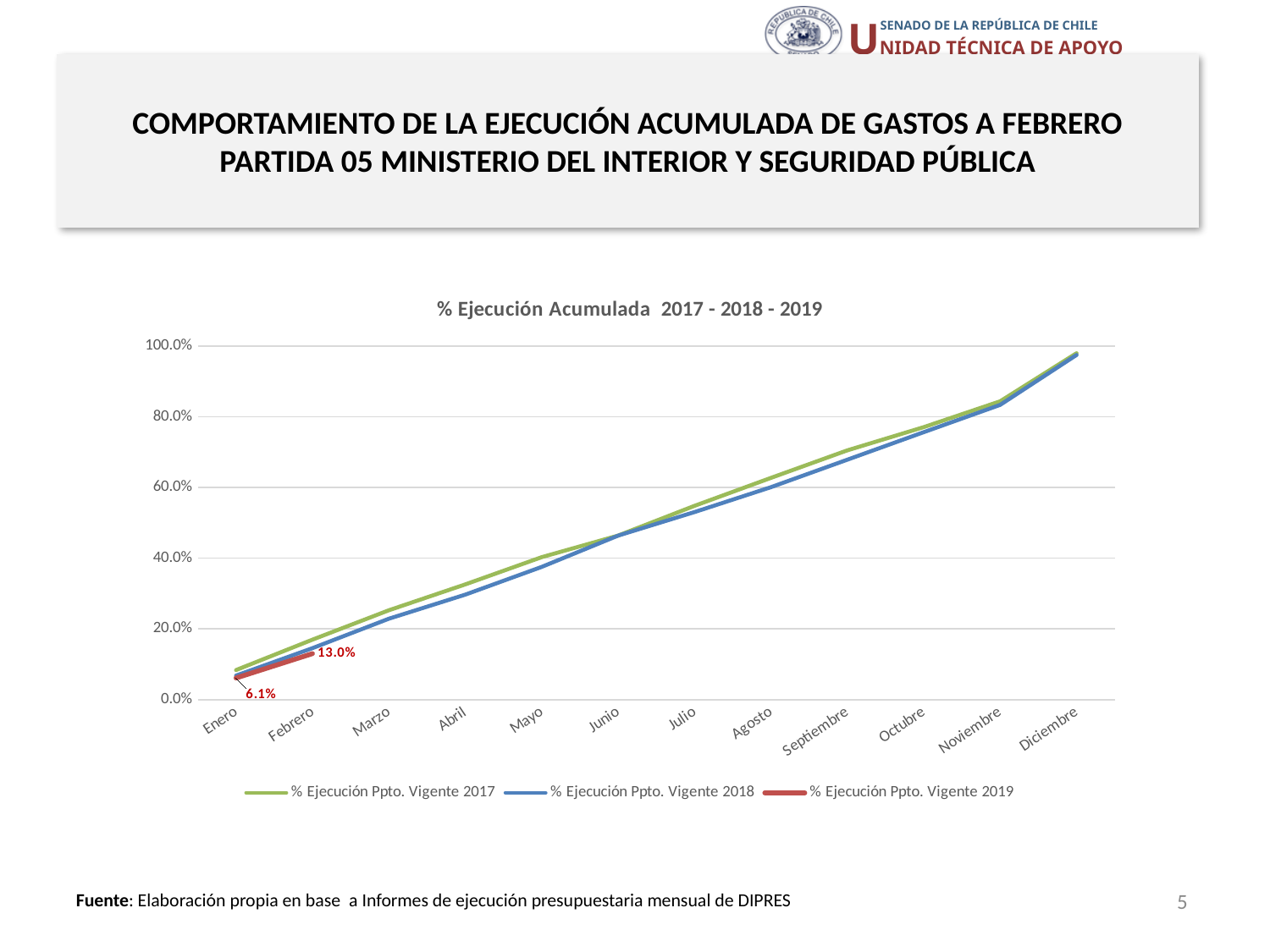
By how much did % Ejecución Ppto. Vigente 2019 increase from Enero to Febrero? 6.9% What is the value for % Ejecución Ppto. Vigente 2019 in Febrero? 13.0% How many series does the legend list? 3 How many months are shown on the x axis? 12 Is the value for % Ejecución Ppto. Vigente 2018 in Marzo greater or less than 40.0%? less What is the value for % Ejecución Ppto. Vigente 2019 in Enero? 6.1% Do the values for % Ejecución Ppto. Vigente 2017 rise or fall from Enero to Diciembre? Rise Is the value for % Ejecución Ppto. Vigente 2018 in Diciembre greater or less than 80.0%? greater Which is larger for % Ejecución Ppto. Vigente 2019: the Enero value or the Febrero value? Febrero What kind of chart is shown on the slide? Line chart What is the title of the chart? % Ejecución Acumulada 2017 - 2018 - 2019 In which month does % Ejecución Ppto. Vigente 2017 reach its highest value? Diciembre